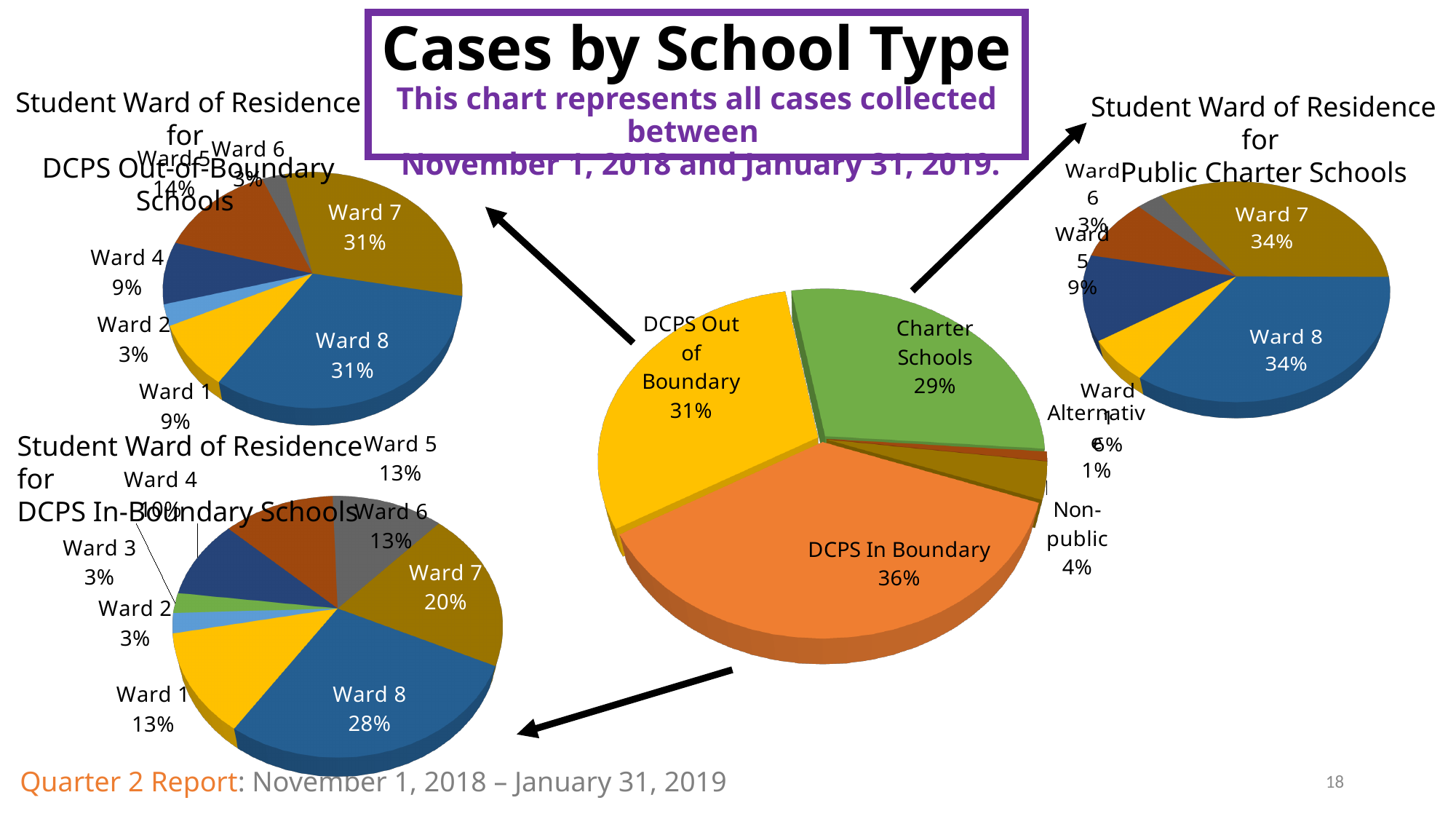
In the central Cases by School Type pie chart, which category has the largest share? DCPS In Boundary In the Student Ward of Residence for DCPS In-Boundary Schools pie chart, which is larger, Ward 7 or Ward 1? Ward 7 In the Student Ward of Residence for DCPS In-Boundary Schools pie chart, what share is Ward 8? 28% In the Student Ward of Residence for DCPS Out-of-Boundary Schools pie chart, what is the difference between the Ward 8 share and the Ward 4 share? 22% In the central Cases by School Type pie chart, what is the difference between the DCPS Out of Boundary share and the Non-public share? 27% In the Student Ward of Residence for DCPS Out-of-Boundary Schools pie chart, what share is Ward 5? 14% In the central Cases by School Type pie chart, what share of cases is Charter Schools? 29% What kind of chart is used for the Student Ward of Residence for Public Charter Schools? Pie chart In the Student Ward of Residence for DCPS In-Boundary Schools pie chart, which ward has the largest share? Ward 8 In the central Cases by School Type pie chart, which category has the smallest share? Alternative